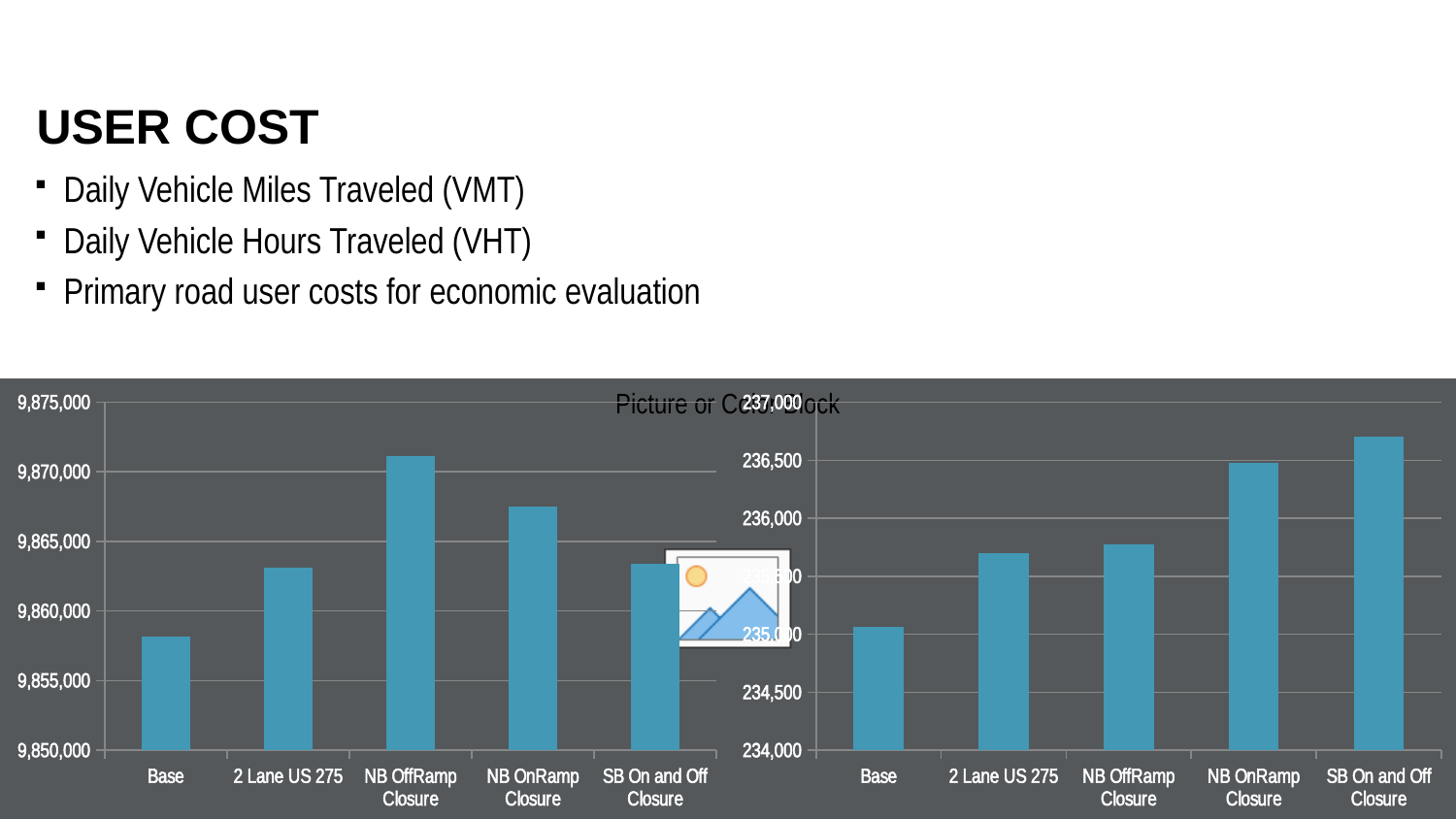
What kind of chart is the left chart? bar chart How many categories are shown on the right chart? 5 On the right chart, which category has the highest value? SB On and Off Closure On the left chart, which is larger, the value for NB OnRamp Closure or the value for 2 Lane US 275? NB OnRamp Closure On the left chart, is the value for NB OffRamp Closure greater or less than 9,870,000? greater On the right chart, is the value for 2 Lane US 275 greater or less than 236,000? less On the right chart, is the value for NB OnRamp Closure greater or less than 236,000? greater On the right chart, which is larger, the value for Base or the value for NB OffRamp Closure? NB OffRamp Closure On the left chart, which category has the lowest value? Base On the right chart, which category has the lowest value? Base On the left chart, which category has the highest value? NB OffRamp Closure